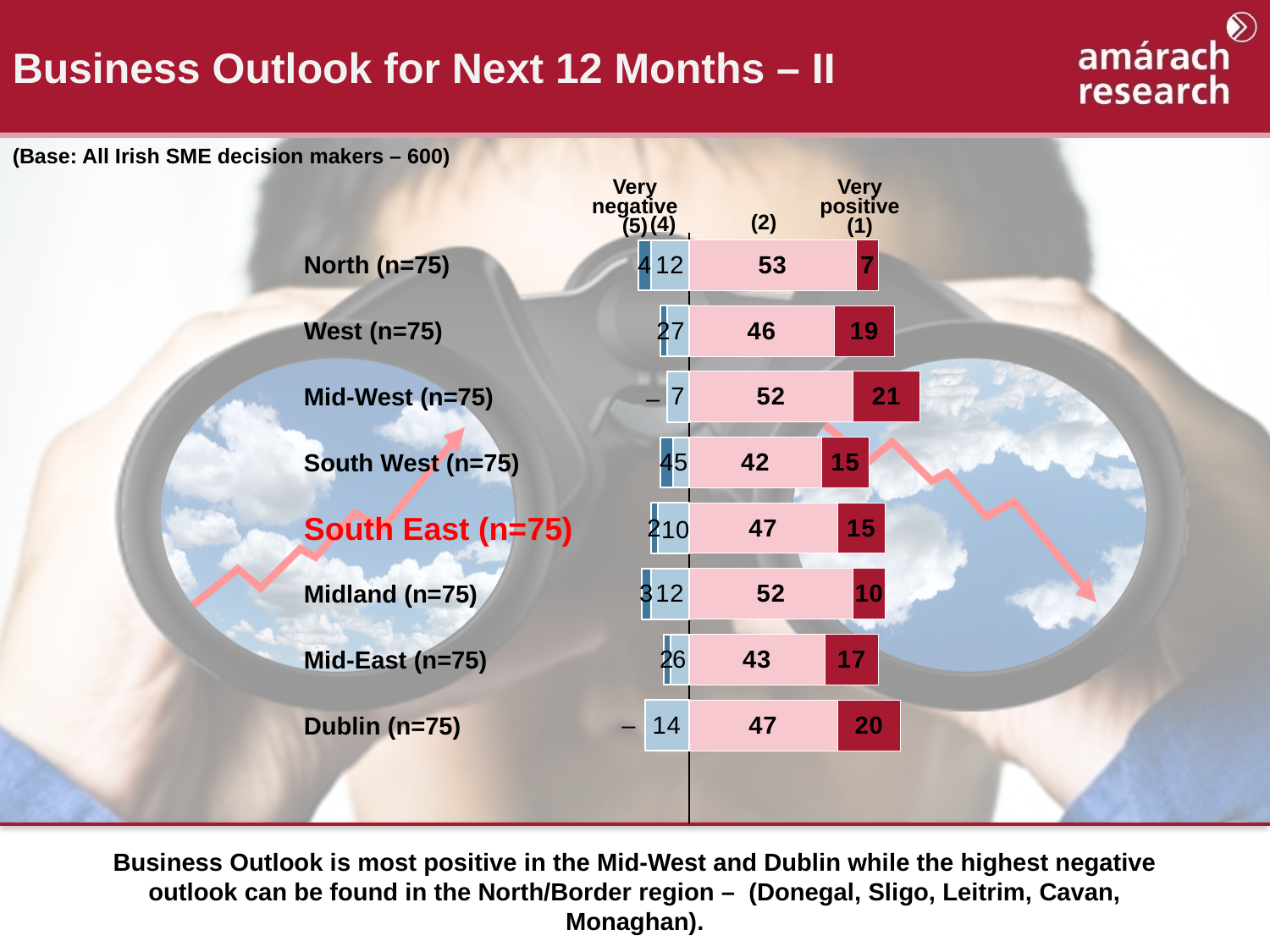
How many regions are shown in the chart? 8 What is the value of the (2) segment for the North (n=75) region? 53 Which region has the lowest Very positive (1) value? North (n=75) What type of chart is shown on the slide? Stacked bar chart What is the (4) value for South East (n=75)? 10 What is the difference between the Very positive (1) values for West (n=75) and Midland (n=75)? 9 Which region has the highest Very positive (1) value? Mid-West (n=75) Which region label is highlighted in red on the slide? South East (n=75) Which region has a larger (2) value, South West (n=75) or Mid-East (n=75)? Mid-East (n=75) What is the total of the stacked bar for North (n=75), summing the (5), (4), (2) and (1) segments? 76 What is the Very positive (1) value for Dublin (n=75)? 20 What is the base stated for the chart? All Irish SME decision makers – 600